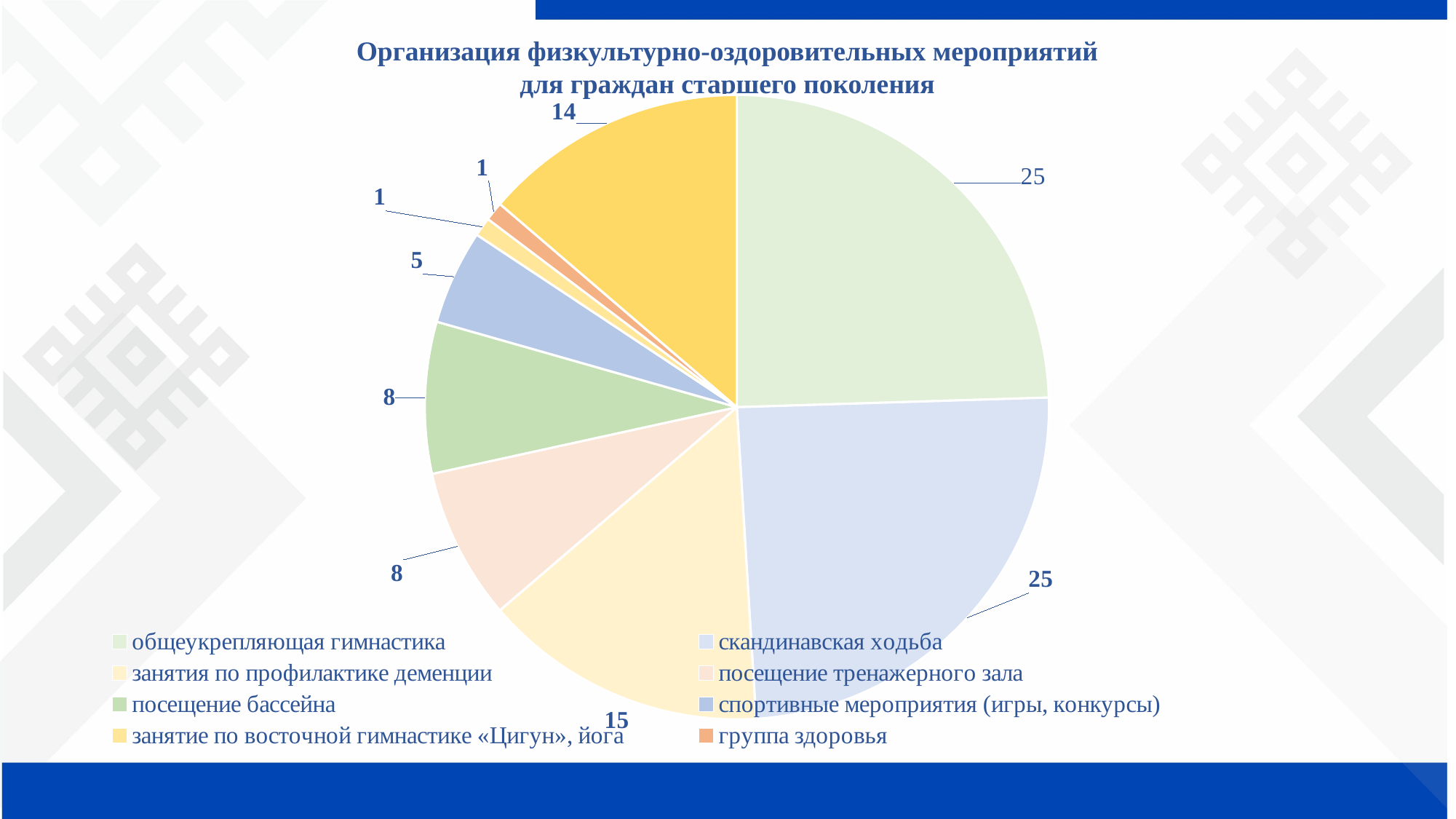
What is the value for занятия по профилактике деменции? 15 What kind of chart is shown on the slide? pie chart What is the title of the chart? Организация физкультурно-оздоровительных мероприятий для граждан старшего поколения What is the value for спортивные мероприятия (игры, конкурсы)? 5 How many entries does the legend list? 8 Which is larger: посещение бассейна or спортивные мероприятия (игры, конкурсы)? посещение бассейна What is the value for посещение бассейна? 8 What is the value for группа здоровья? 1 What is the value for скандинавская ходьба? 25 What is the difference between the values for скандинавская ходьба and занятия по профилактике деменции? 10